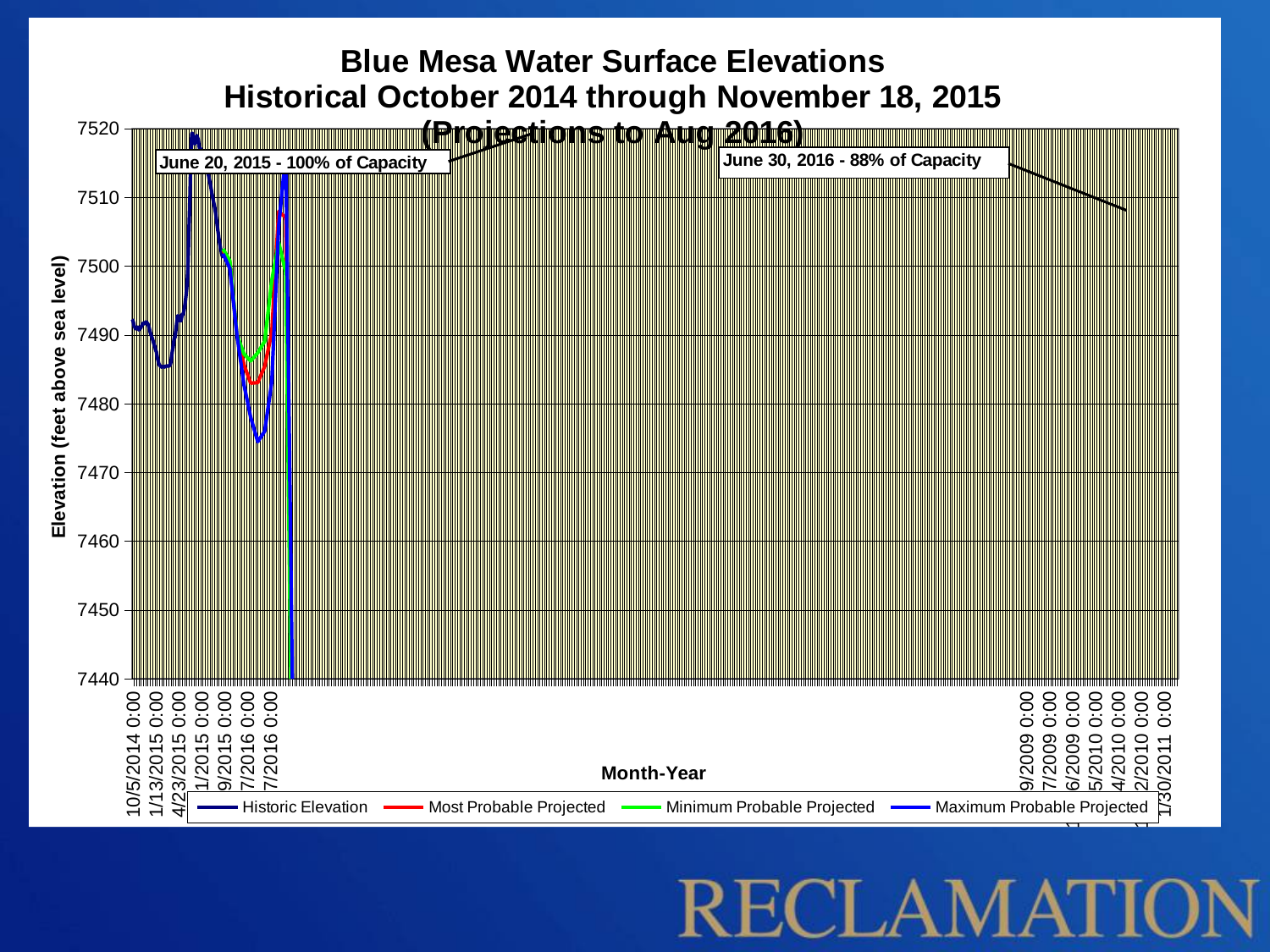
Is the lowest point of the Most Probable Projected line greater or less than 7490? less What is the title of the x-axis? Month-Year According to the annotation, what percent of capacity was Blue Mesa at on June 20, 2015? 100% of Capacity Which projected series dips to the lowest elevation: Minimum Probable Projected or Maximum Probable Projected? Maximum Probable Projected Is the lowest point of the Most Probable Projected line greater or less than 7480? greater Is the peak of the Historic Elevation line in mid-2015 greater or less than 7510? greater How many series does the chart legend list? 4 What is the title of the y-axis? Elevation (feet above sea level) According to the annotation, what percent of capacity is projected for June 30, 2016? 88% of Capacity Does the Historic Elevation line rise or fall between its low in early 2015 and its peak in mid-2015? rise What type of chart is shown on the slide? line chart